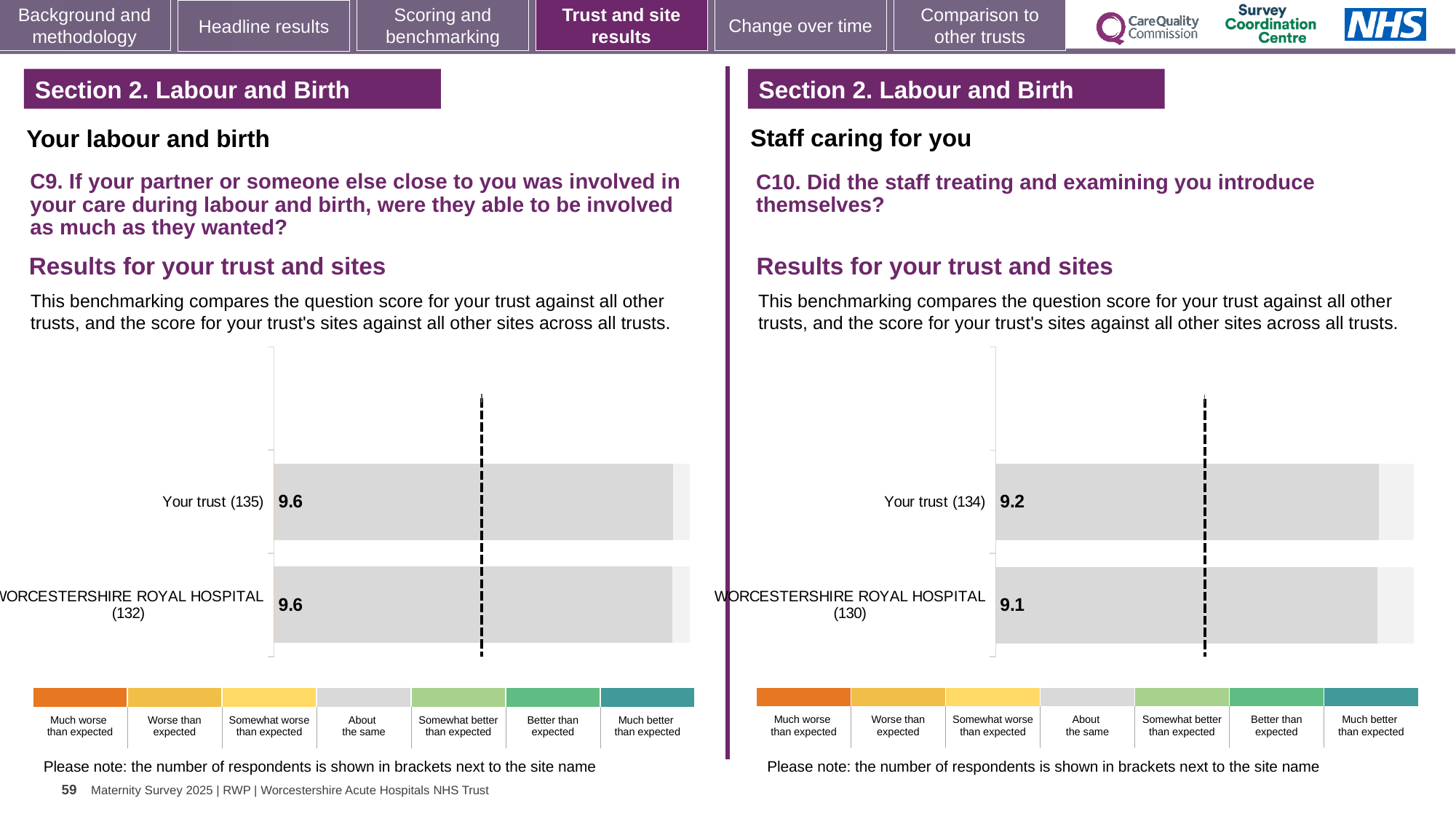
What type of chart is used on the right (C10)? Bar chart On the left chart (C9), what is the score for WORCESTERSHIRE ROYAL HOSPITAL (132)? 9.6 On the right chart (C10), how many respondents are shown in brackets for Your trust? 134 On the right chart (C10), which has the higher score, Your trust or WORCESTERSHIRE ROYAL HOSPITAL? Your trust On the right chart (C10), what is the difference between the score for Your trust and the score for WORCESTERSHIRE ROYAL HOSPITAL? 0.1 On the right chart (C10), what is the score for Your trust (134)? 9.2 On the left chart (C9), how many respondents are shown in brackets for WORCESTERSHIRE ROYAL HOSPITAL? 132 On the left chart (C9), is the score for Your trust the same as the score for WORCESTERSHIRE ROYAL HOSPITAL? Yes, both are 9.6 On the left chart (C9), what is the score for Your trust (135)? 9.6 How many categories does the colour legend below the left chart (C9) list? 7 On the right chart (C10), what is the score for WORCESTERSHIRE ROYAL HOSPITAL (130)? 9.1 How many bars are plotted on the left chart (C9)? 2